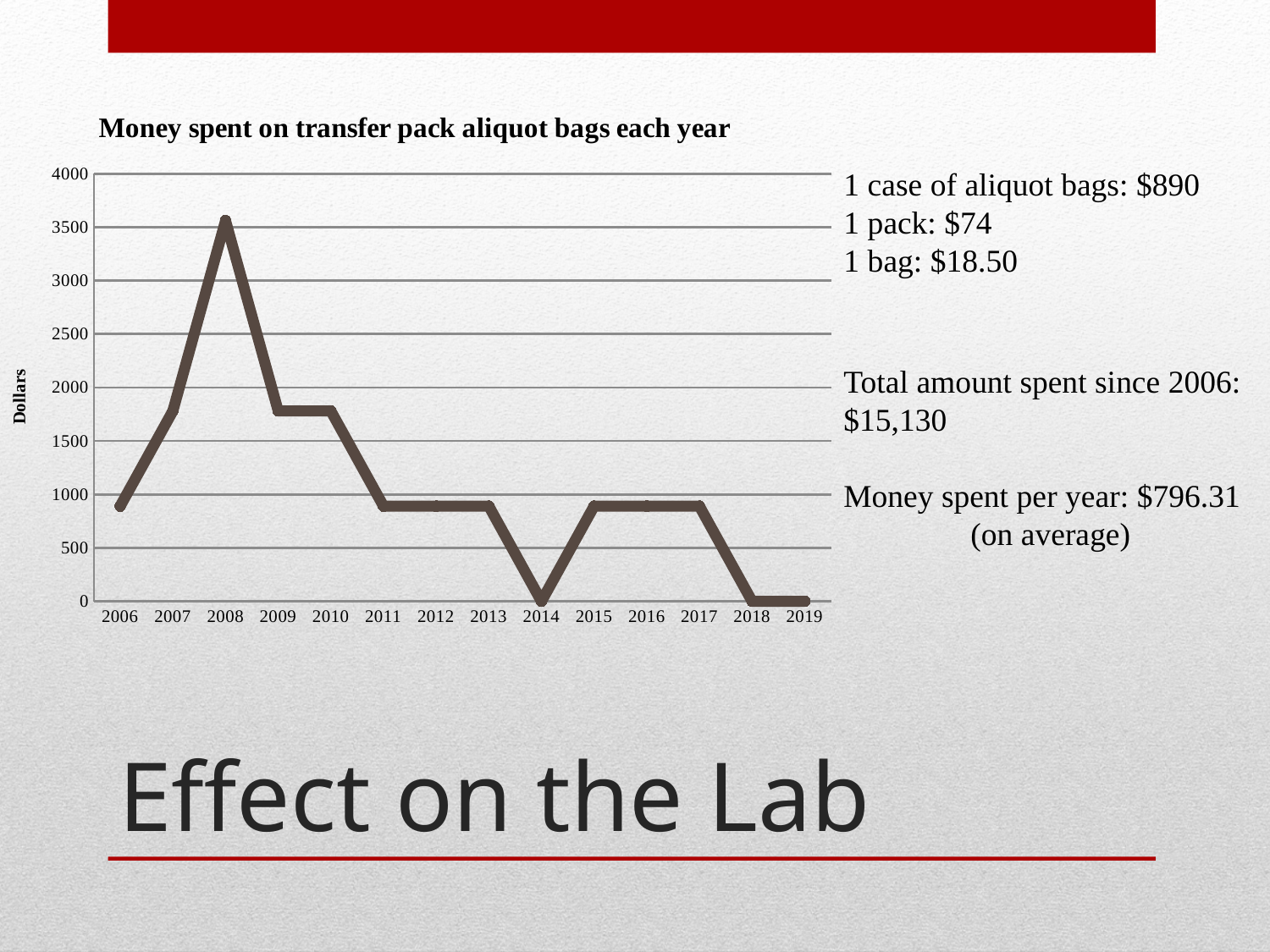
In which year was the money spent on transfer pack aliquot bags highest? 2008 Which year has the larger value, 2009 or 2011? 2009 Is the value for 2006 greater or less than 1000? less What value does the chart show for 2014? 0 Is the value for 2007 greater or less than 1500? greater What value does the chart show for 2019? 0 What is the label on the vertical axis of the chart? Dollars What is the title of the chart? Money spent on transfer pack aliquot bags each year Do the values rise or fall from 2008 to 2011? fall How many years are plotted along the x axis of the chart? 14 What kind of chart is shown on the slide? line chart Is the value for 2008 greater or less than 3000? greater